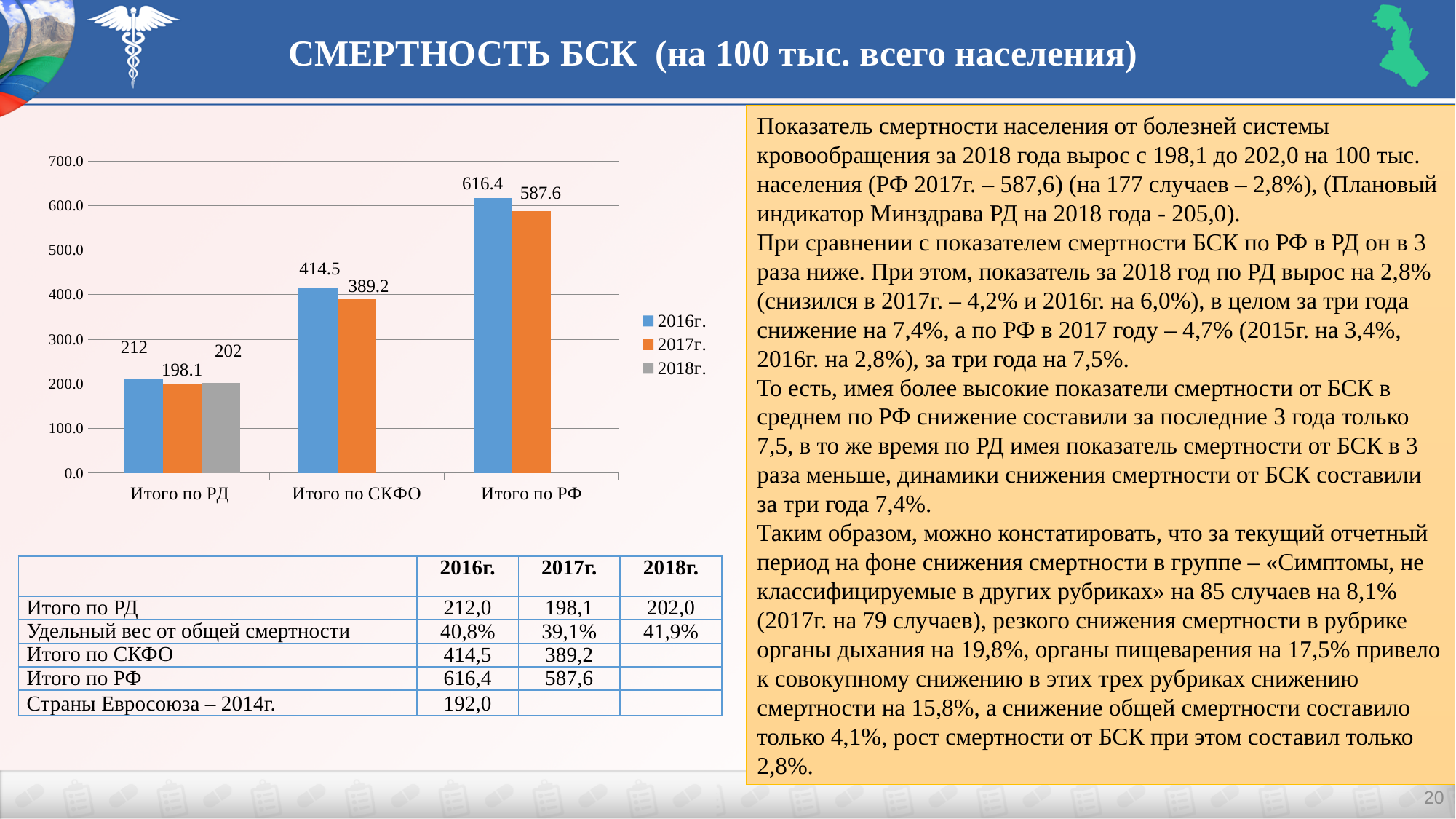
Which category has the highest value for 2016г.? Итого по РФ What is the difference between the 2016г. and 2017г. values for Итого по РФ? 28.8 What is the value for 2017г. in the category Итого по СКФО? 389.2 Which is larger for Итого по РД: the 2016г. value or the 2018г. value? 2016г. What is the value for 2016г. in the category Итого по РФ? 616.4 Which category has no bar for 2018г. but the highest 2017г. value? Итого по РФ Which category has the lowest value for 2017г.? Итого по РД How many series does the chart legend list? 3 Which series is shown in grey in the chart legend? 2018г. What kind of chart is shown on the slide? bar chart What is the value for 2018г. in the category Итого по РД? 202 How many categories are shown on the x axis of the chart? 3